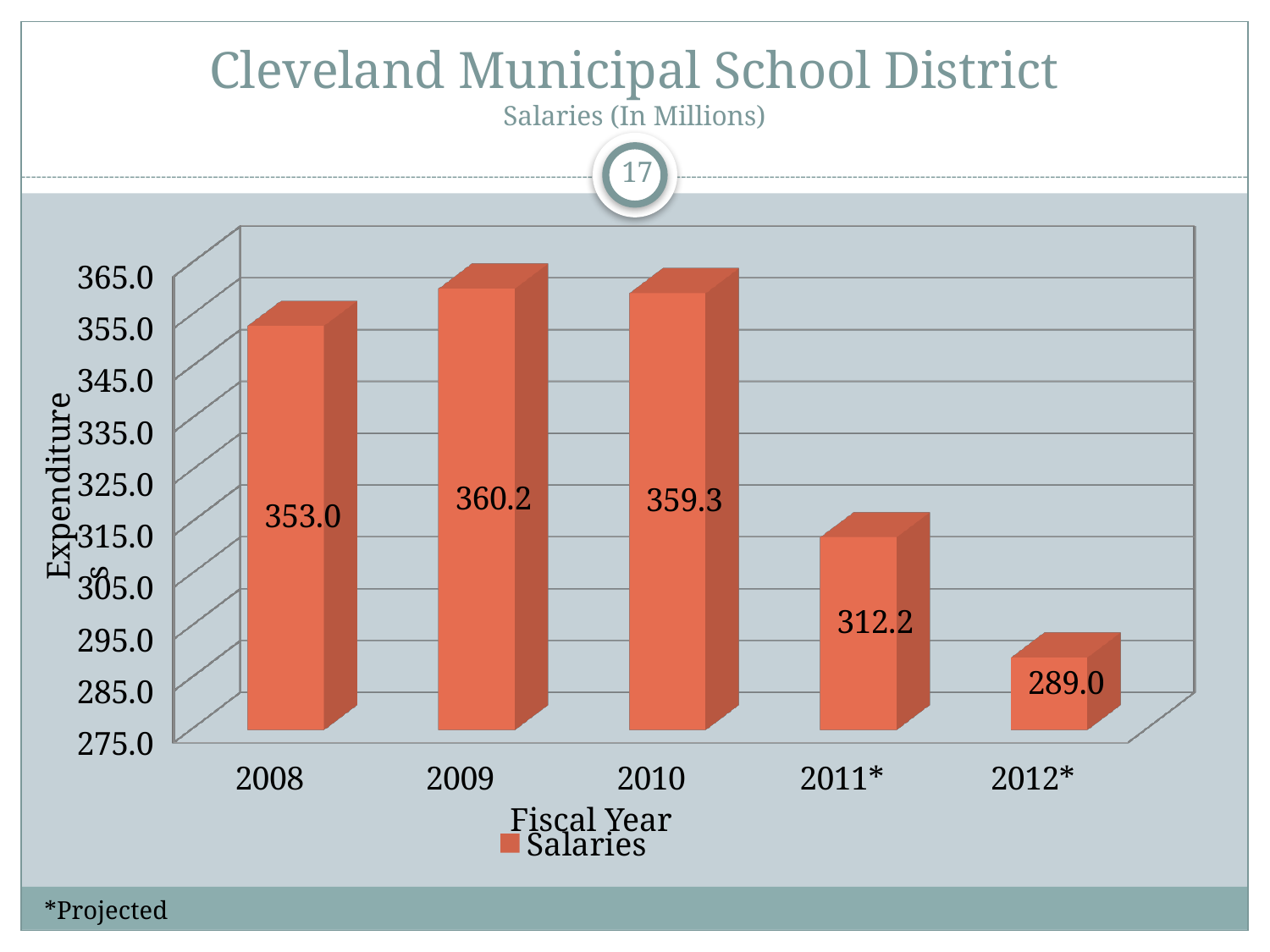
How many series does the legend list? 1 Which fiscal year has the lowest salaries value? 2012* Which fiscal year has the highest salaries value? 2009 Do the salaries values rise or fall from 2010 to 2012*? Fall How many fiscal years are shown on the x axis? 5 What kind of chart is shown on the slide? Bar chart What is the difference between the salaries values for 2009 and 2012*? 71.2 What is the salaries value for fiscal year 2012*? 289.0 What is the difference between the salaries values for 2010 and 2011*? 47.1 Which fiscal year has a larger salaries value, 2008 or 2011*? 2008 What is the salaries value for fiscal year 2011*? 312.2 What is the salaries value for fiscal year 2008? 353.0